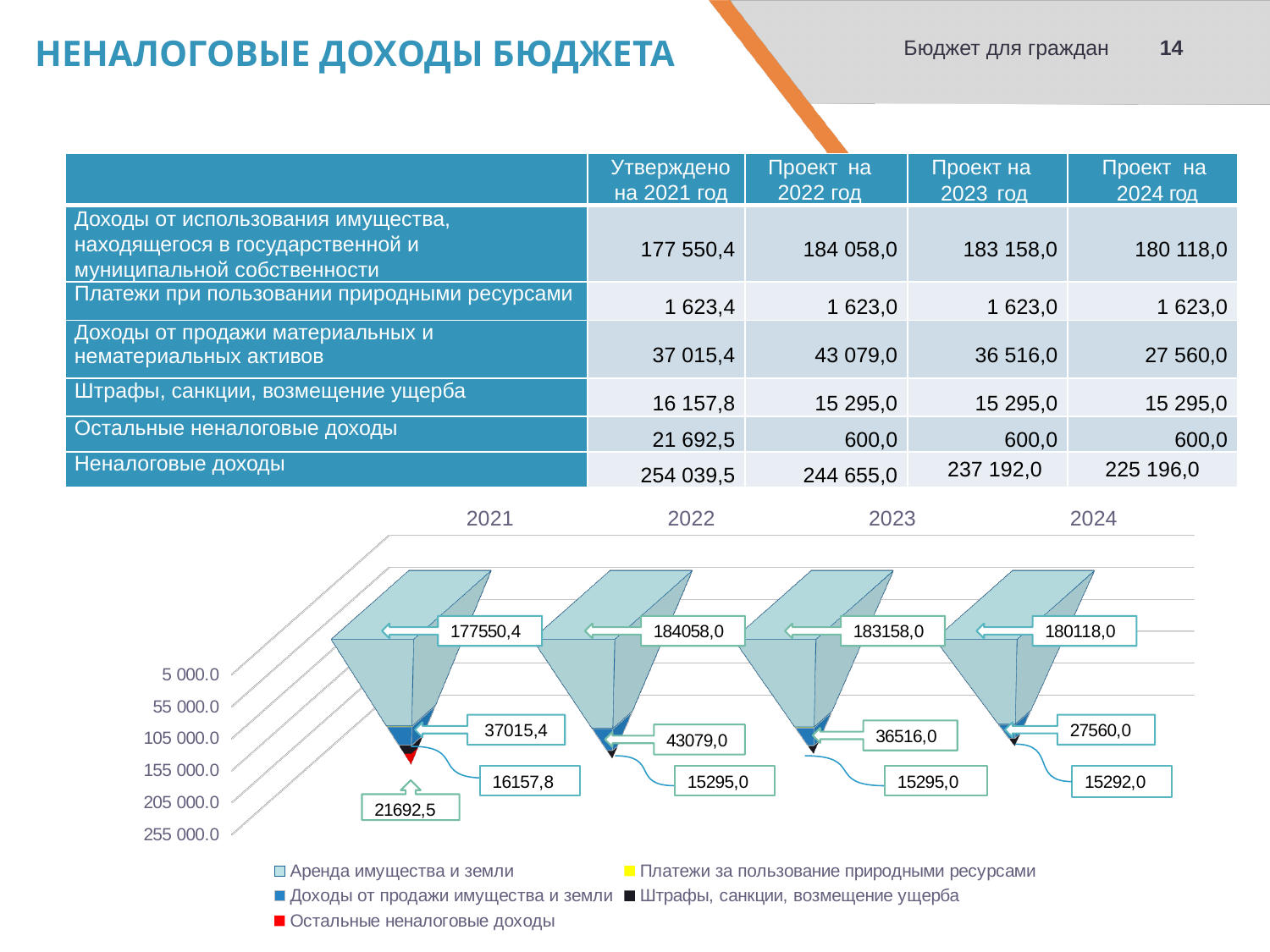
In the chart, what is the difference between the 'Доходы от продажи имущества и земли' values for 2022 and 2023? 6563,0 In the chart, is the 'Аренда имущества и земли' value larger in 2023 or in 2024? 2023 In the chart, does the 'Доходы от продажи имущества и земли' value rise or fall from 2022 to 2024? fall In the chart, what is the data label for 'Аренда имущества и земли' in 2021? 177550,4 In the chart, what is the data label for 'Доходы от продажи имущества и земли' in 2024? 27560,0 In the chart, which year has the highest value for 'Аренда имущества и земли'? 2022 In the chart, what is the data label for 'Аренда имущества и земли' in 2022? 184058,0 In the chart, what is the data label for 'Штрафы, санкции, возмещение ущерба' in 2021? 16157,8 In the chart, which year has the lowest value for 'Доходы от продажи имущества и земли'? 2024 How many series does the chart legend list? 5 How many years are shown along the x axis of the chart? 4 In the chart, what is the data label for 'Остальные неналоговые доходы' in 2021? 21692,5